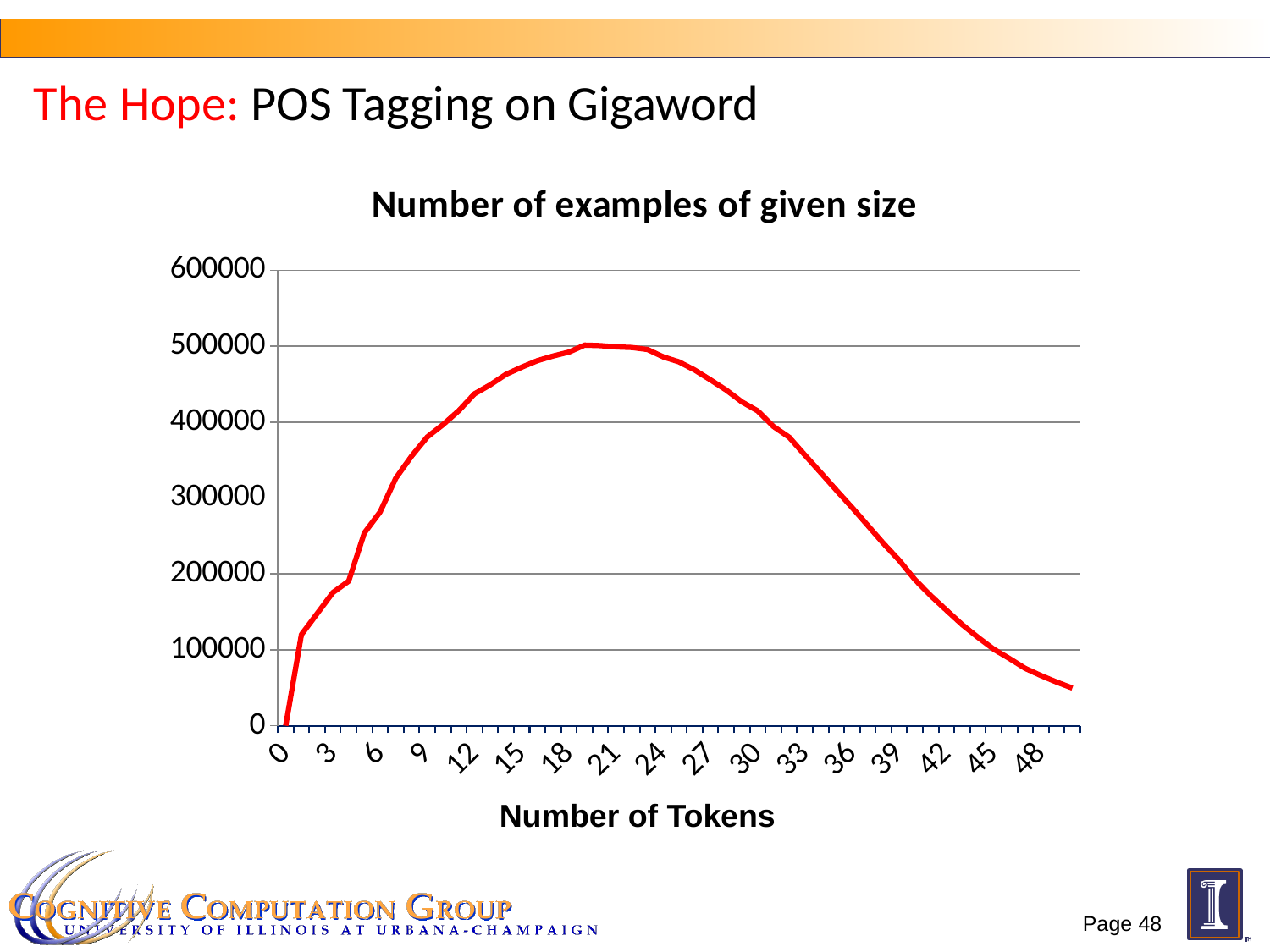
Do the values rise or fall along the x axis from 27 tokens to 48 tokens? fall Is the value at 33 tokens greater or less than 400000? less Which is larger, the value at 12 tokens or the value at 42 tokens? 12 tokens Is the value at 12 tokens greater or less than 400000? greater Is the value at 9 tokens greater or less than 400000? less What is the value at 0 tokens? 0 What is the title of the chart? Number of examples of given size What kind of chart is shown on the slide? line chart What is the label of the x axis? Number of Tokens